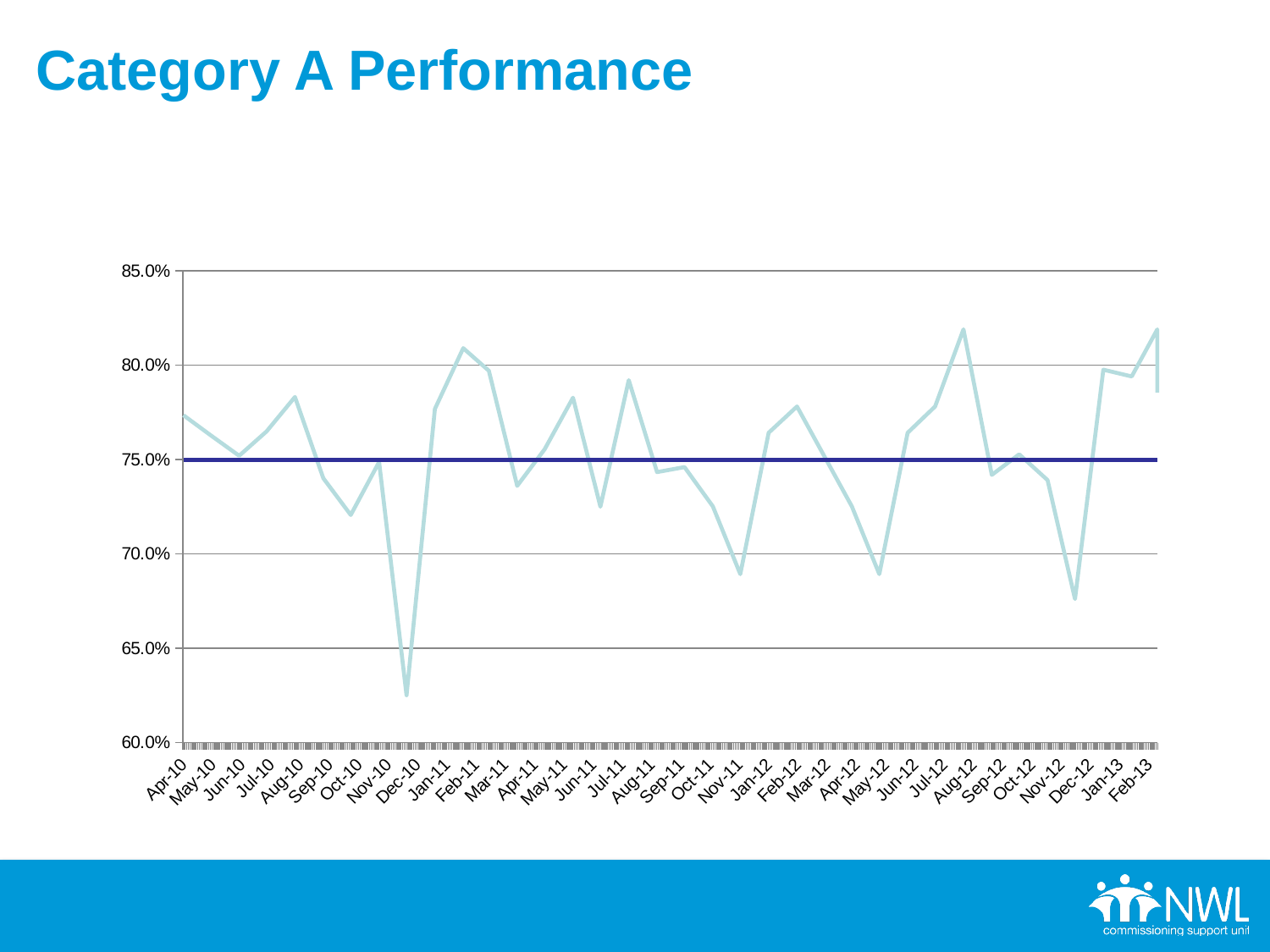
Does the light blue line rise or fall from Dec-10 to Feb-11? rise What is the title of the chart? Category A Performance At what level does the dark blue horizontal line sit on the y axis? 75.0% Is the value for Dec-12 greater or less than 70.0%? less Is the value for Dec-10 greater or less than 65.0%? less Which month has the lowest value on the light blue line? Dec-10 Is the value for Feb-11 greater or less than 80.0%? greater Which is larger, the value for Dec-10 or the value for Jan-11? Jan-11 What kind of chart is shown on the slide? line chart